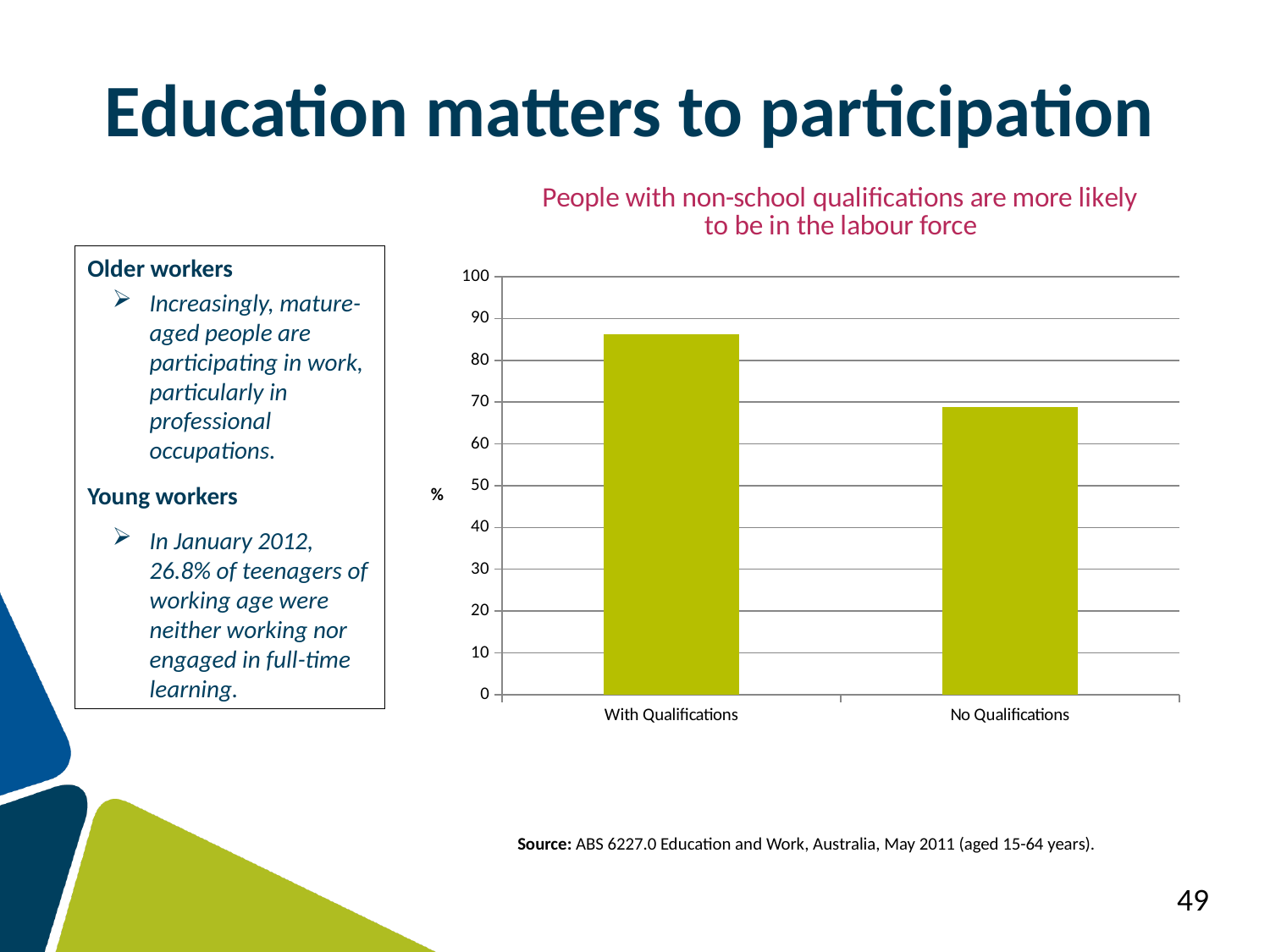
Which category has the lowest value on the chart? No Qualifications Is the value for No Qualifications greater or less than 60? greater What is the maximum value shown on the vertical axis of the chart? 100 What kind of chart is shown on the slide? bar chart What is the label on the vertical axis of the chart? % What is the title of the chart? People with non-school qualifications are more likely to be in the labour force How many categories are plotted on the chart? 2 Is the value for With Qualifications greater or less than 80? greater Which is larger, the value for With Qualifications or the value for No Qualifications? With Qualifications Is the value for With Qualifications greater or less than 90? less Which category has the highest value on the chart? With Qualifications